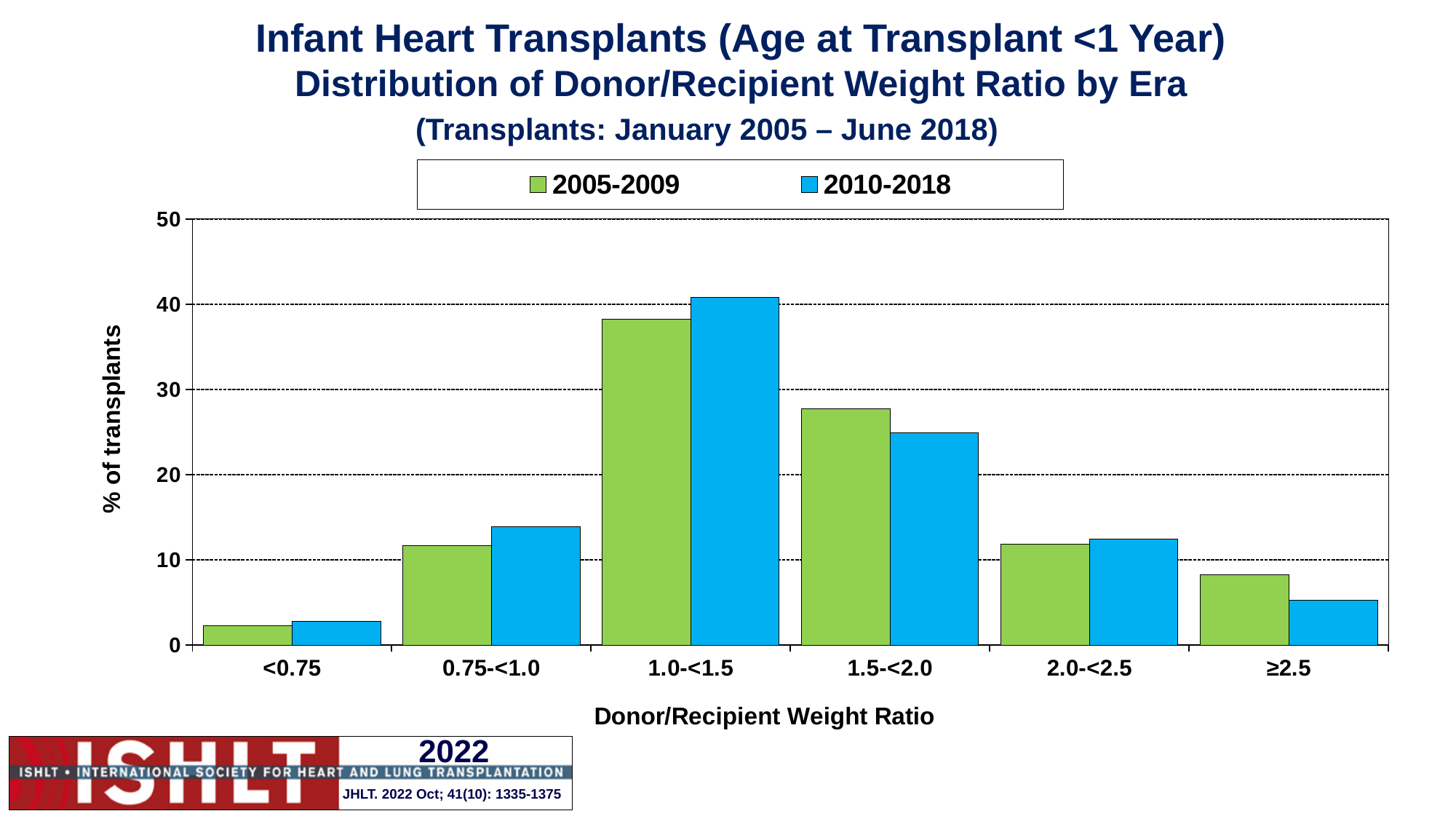
Is the value for 2005-2009 in the 1.0-<1.5 category greater or less than 40? less How many series does the legend list? 2 How many donor/recipient weight ratio categories are shown on the x axis? 6 In the ≥2.5 category, which era has the larger percentage of transplants, 2005-2009 or 2010-2018? 2005-2009 What is the label of the y axis? % of transplants Is the value for 2010-2018 in the 0.75-<1.0 category greater or less than 10? greater For the 2010-2018 series, which weight ratio category has the lowest percentage of transplants? <0.75 For the 2010-2018 series, which weight ratio category has the highest percentage of transplants? 1.0-<1.5 For the 2005-2009 series, which weight ratio category has the highest percentage of transplants? 1.0-<1.5 In the 1.5-<2.0 category, which era has the larger percentage of transplants, 2005-2009 or 2010-2018? 2005-2009 For the 2005-2009 series, which weight ratio category has the lowest percentage of transplants? <0.75 What kind of chart is shown on the slide? bar chart